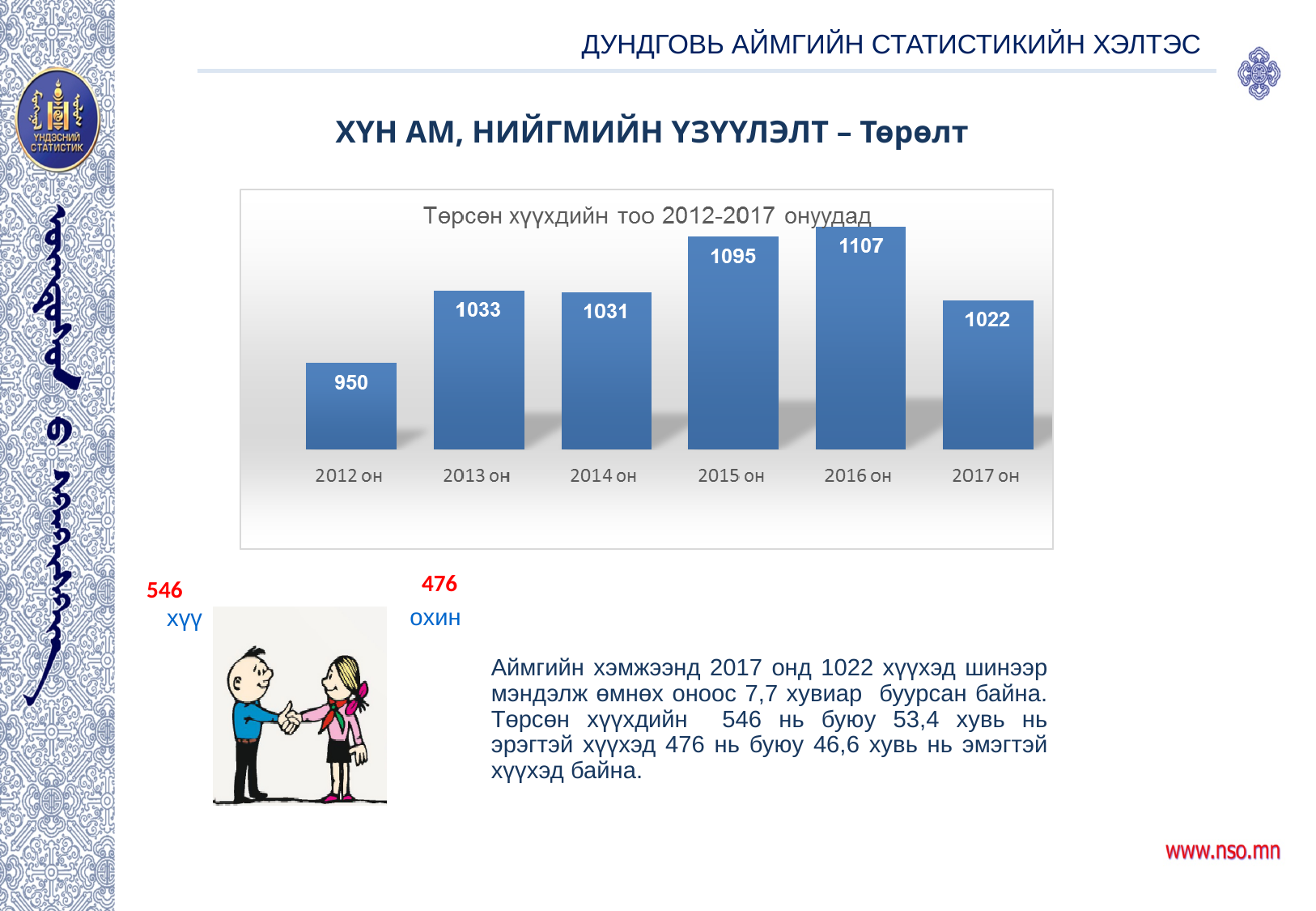
What is the difference between the values for 2013 он and 2012 он? 83 What is the number of children born in 2012 он according to the chart? 950 Which year has the highest number of births in the chart? 2016 он Which is larger, the value for 2015 он or the value for 2014 он? 2015 он Does the value rise or fall from 2016 он to 2017 он? Fall What type of chart is shown on the slide? Bar chart How many years (categories) are shown in the chart? 6 What is the difference between the values for 2016 он and 2017 он? 85 Which year has the lowest number of births in the chart? 2012 он What value is shown for 2017 он in the chart? 1022 What is the title of the chart? Төрсөн хүүхдийн тоо 2012-2017 онуудад What value is shown for 2016 он in the chart? 1107